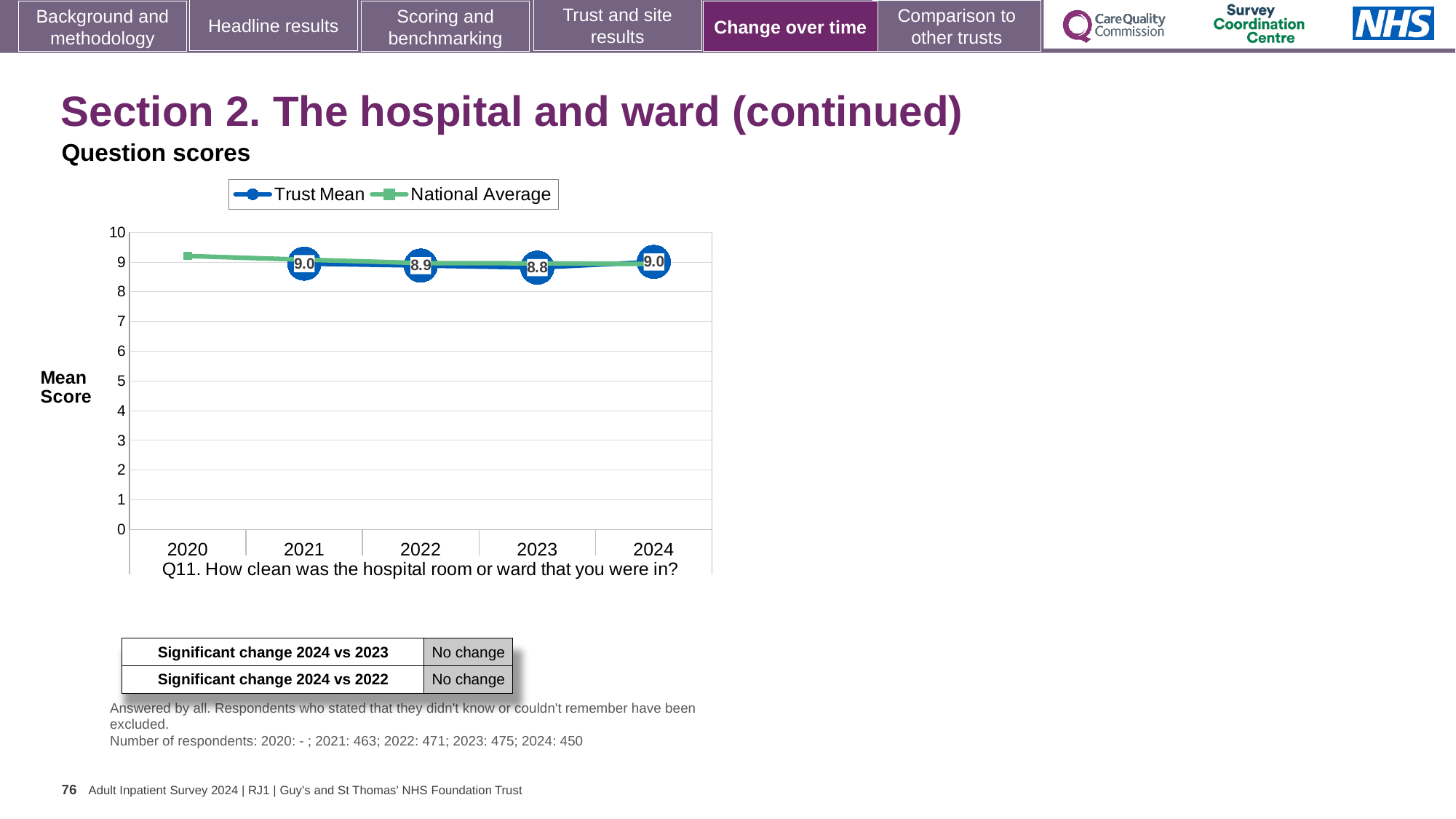
What is the Trust Mean value for 2023? 8.8 In which year is the Trust Mean lowest? 2023 What is the Trust Mean value for 2021? 9.0 What is the difference between the Trust Mean in 2021 and in 2023? 0.2 How many series does the legend list? 2 What is the Trust Mean value for 2022? 8.9 Is the National Average value for 2020 greater or less than 5? greater What is the Trust Mean value for 2024? 9.0 What kind of chart is shown on the slide? Line chart How many years are shown on the x axis? 5 Does the Trust Mean rise or fall from 2021 to 2023? Fall Which is larger, the Trust Mean for 2022 or for 2023? 2022